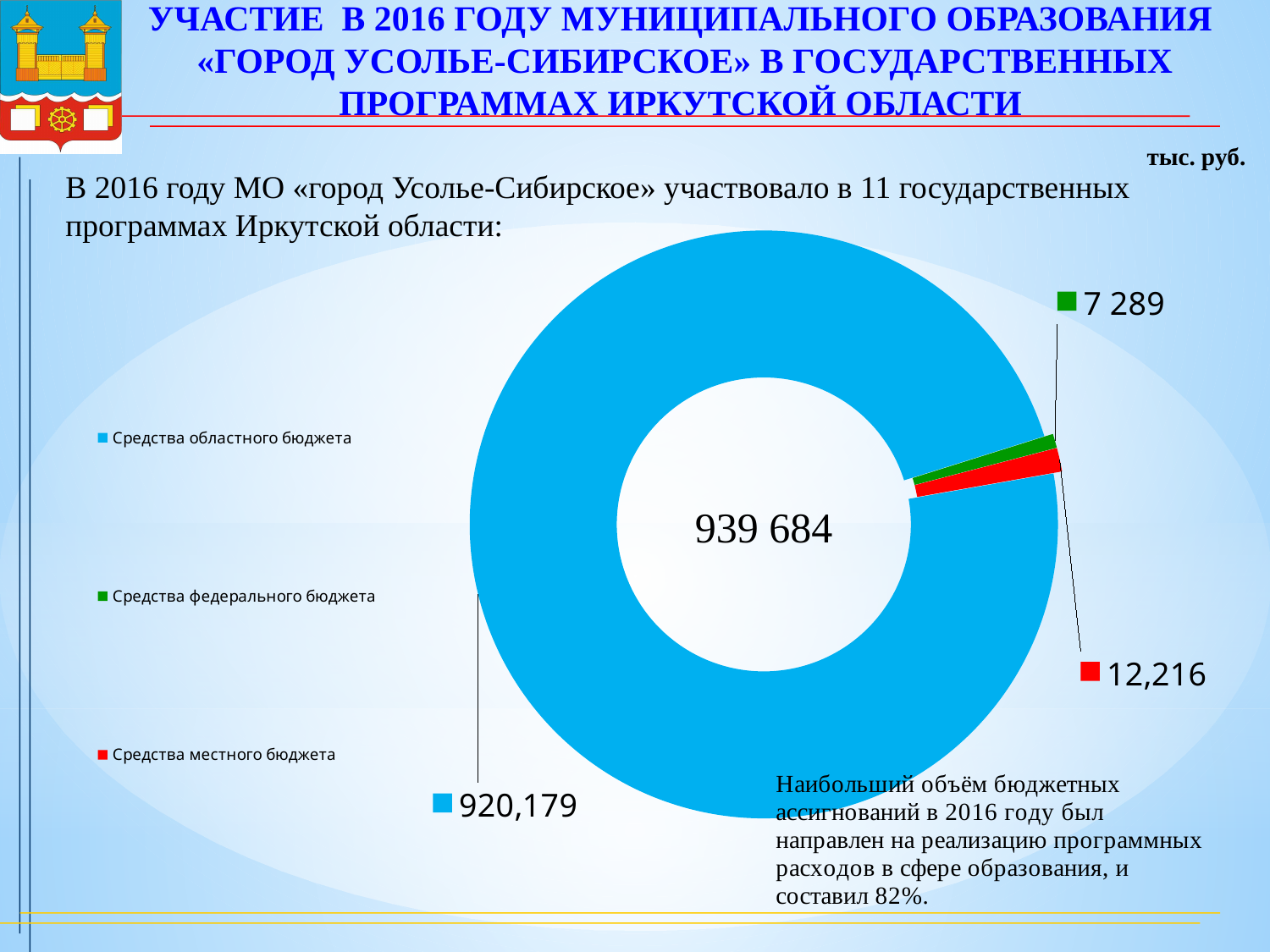
Which is larger: Средства местного бюджета or Средства федерального бюджета? Средства местного бюджета What kind of chart is shown on the slide? doughnut chart How many categories does the chart show? 3 Which category has the smallest value in the chart? Средства федерального бюджета What is the difference between Средства областного бюджета and Средства местного бюджета? 907,963 What value is shown for Средства федерального бюджета? 7 289 What is the difference between Средства местного бюджета and Средства федерального бюджета? 4,927 What value is shown for Средства местного бюджета? 12,216 What value is shown for Средства областного бюджета? 920,179 What colour represents Средства местного бюджета in the chart? red What total value is shown in the centre of the chart? 939 684 Which category has the largest value in the chart? Средства областного бюджета